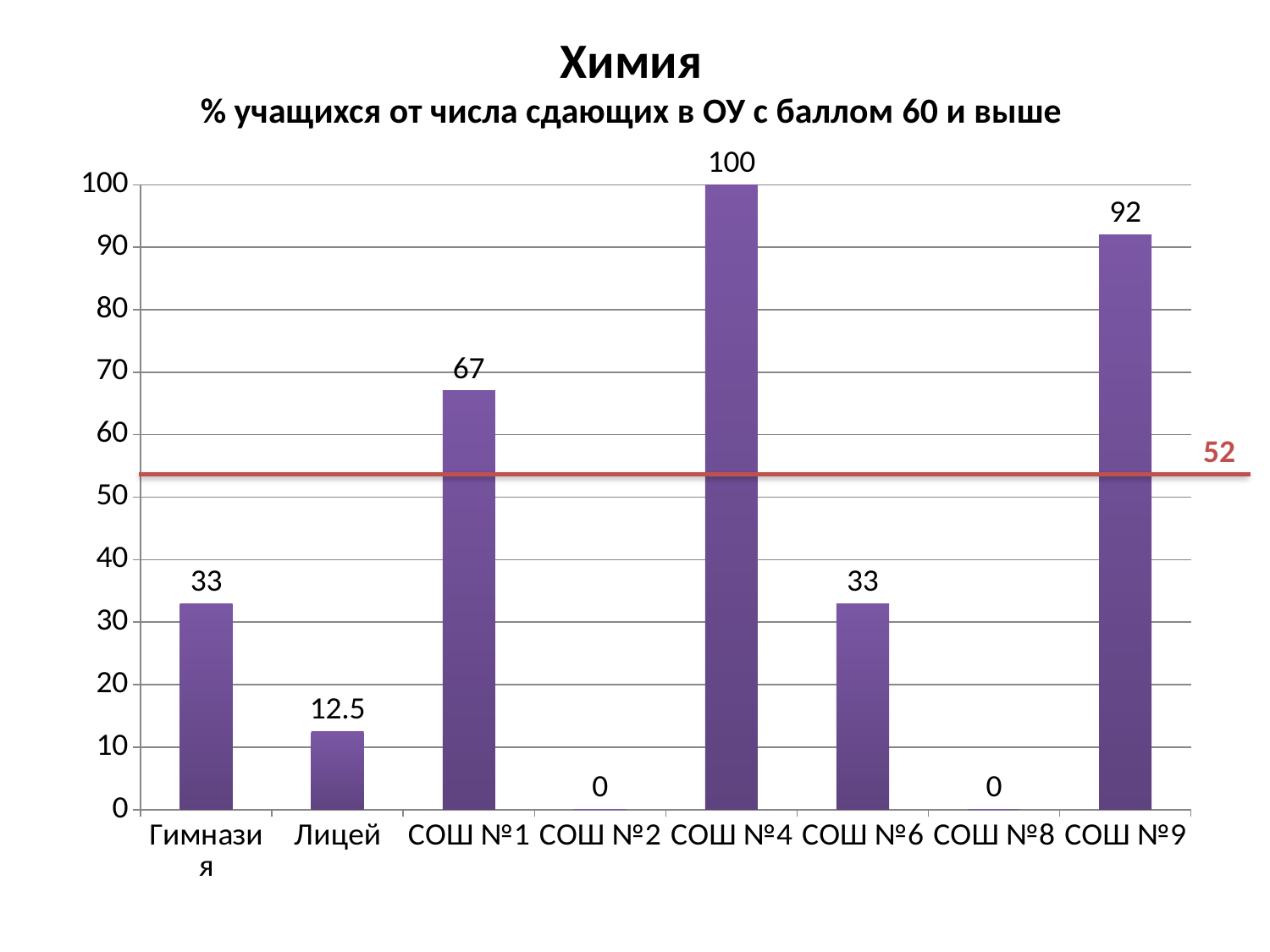
How many categories have a value of 0? 2 What is the value for Лицей? 12.5 Which is larger, the value for Гимназия or the value for Лицей? Гимназия What is the value for СОШ №1? 67 How many categories are shown on the x axis? 8 What is the difference between the values for СОШ №4 and СОШ №9? 8 What is the value for СОШ №9? 92 What kind of chart is this? bar chart Is the value for СОШ №6 greater or less than 50? less Which category has the highest value? СОШ №4 What value is labelled on the red horizontal line? 52 What is the difference between the values for СОШ №1 and Гимназия? 34